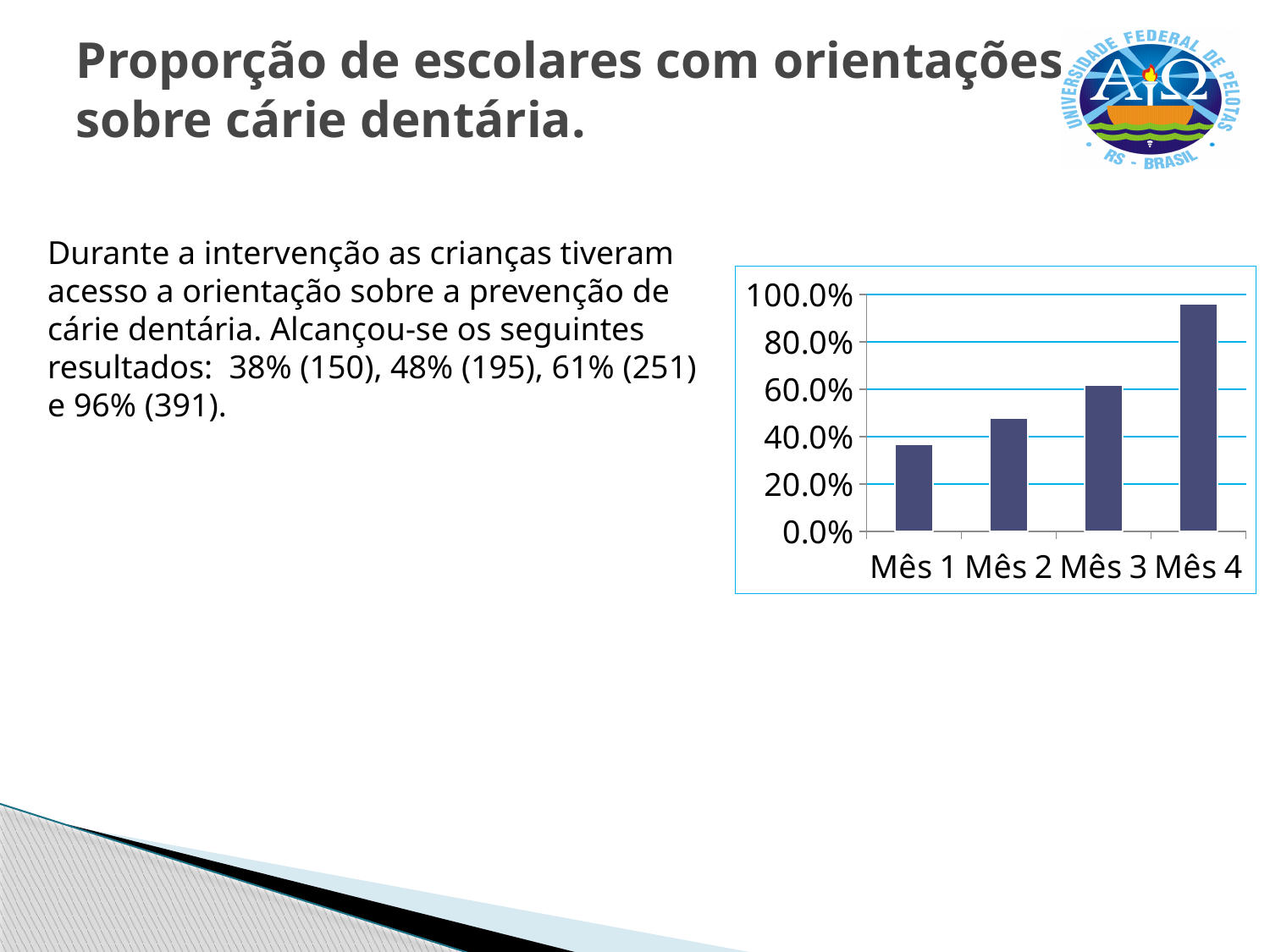
Do the values rise or fall from Mês 1 to Mês 4? rise What is the highest value shown on the y axis of the chart? 100.0% Is the value for Mês 4 greater or less than 80.0%? greater Which month has the highest bar in the chart? Mês 4 Is the value for Mês 3 greater or less than 40.0%? greater Which is larger, the value for Mês 2 or the value for Mês 3? Mês 3 Is the value for Mês 2 greater or less than 60.0%? less How many categories are shown on the x axis of the chart? 4 Which month has the lowest bar in the chart? Mês 1 What is the label of the first category on the x axis? Mês 1 What kind of chart is shown on the slide? bar chart